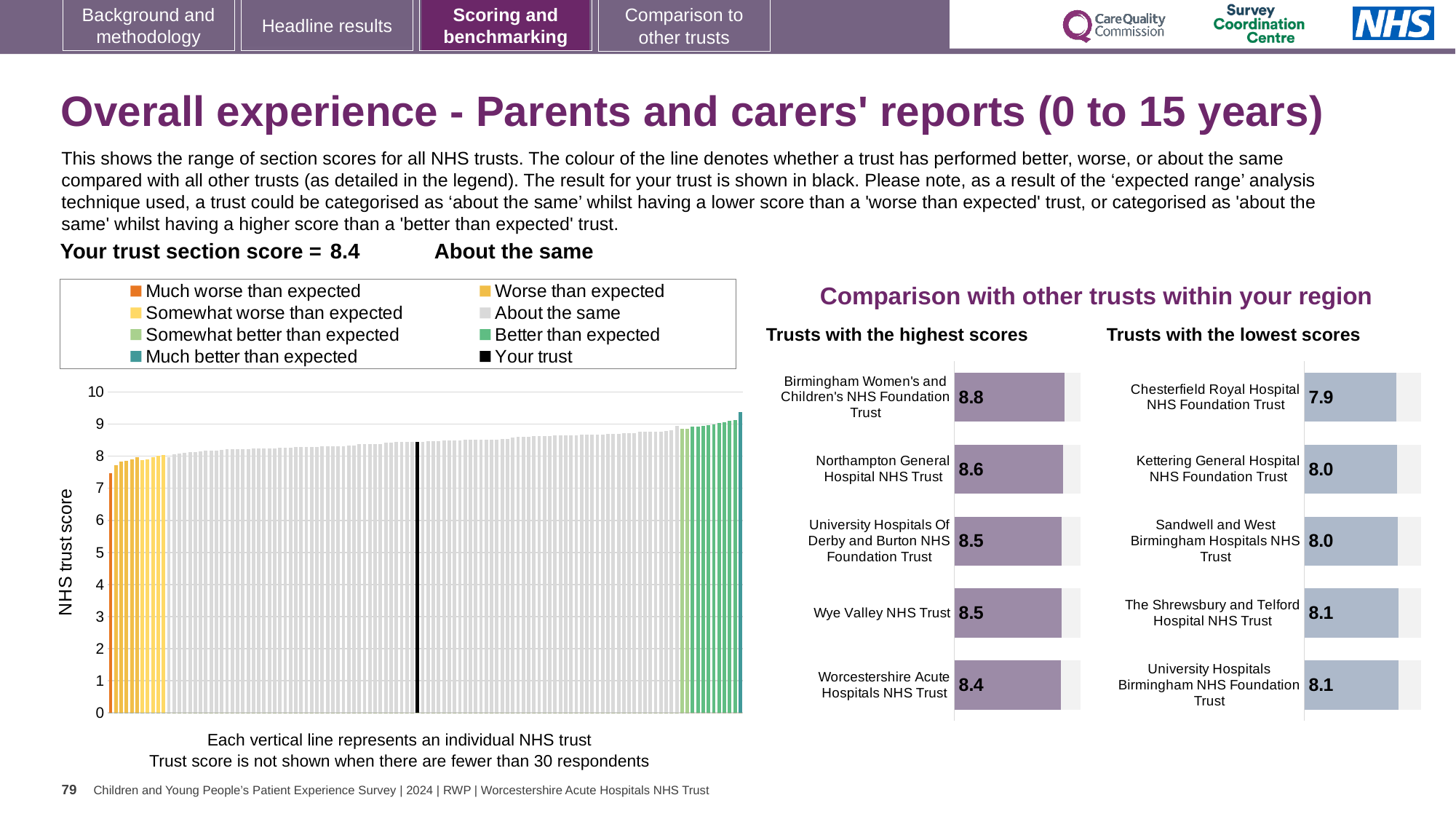
How many entries does the legend of the NHS trust score chart on the left list? 8 In the 'Trusts with the highest scores' chart, what is the difference between the scores of Birmingham Women's and Children's NHS Foundation Trust and Worcestershire Acute Hospitals NHS Trust? 0.4 In the 'Trusts with the highest scores' chart, which trust has the highest score? Birmingham Women's and Children's NHS Foundation Trust In the 'Trusts with the lowest scores' chart, what is the score for Chesterfield Royal Hospital NHS Foundation Trust? 7.9 What kind of chart is the NHS trust score chart on the left? bar chart In the 'Trusts with the lowest scores' chart, which has the larger score: Kettering General Hospital NHS Foundation Trust or Chesterfield Royal Hospital NHS Foundation Trust? Kettering General Hospital NHS Foundation Trust In the NHS trust score chart on the left, is the value of the lowest (orange) bar greater or less than 8? less In the 'Trusts with the highest scores' chart, what is the score for Birmingham Women's and Children's NHS Foundation Trust? 8.8 How many trusts are shown in the 'Trusts with the lowest scores' chart? 5 In the 'Trusts with the highest scores' chart, what is the score for Northampton General Hospital NHS Trust? 8.6 In the 'Trusts with the lowest scores' chart, which trust has the lowest score? Chesterfield Royal Hospital NHS Foundation Trust In the 'Trusts with the lowest scores' chart, what is the score for The Shrewsbury and Telford Hospital NHS Trust? 8.1